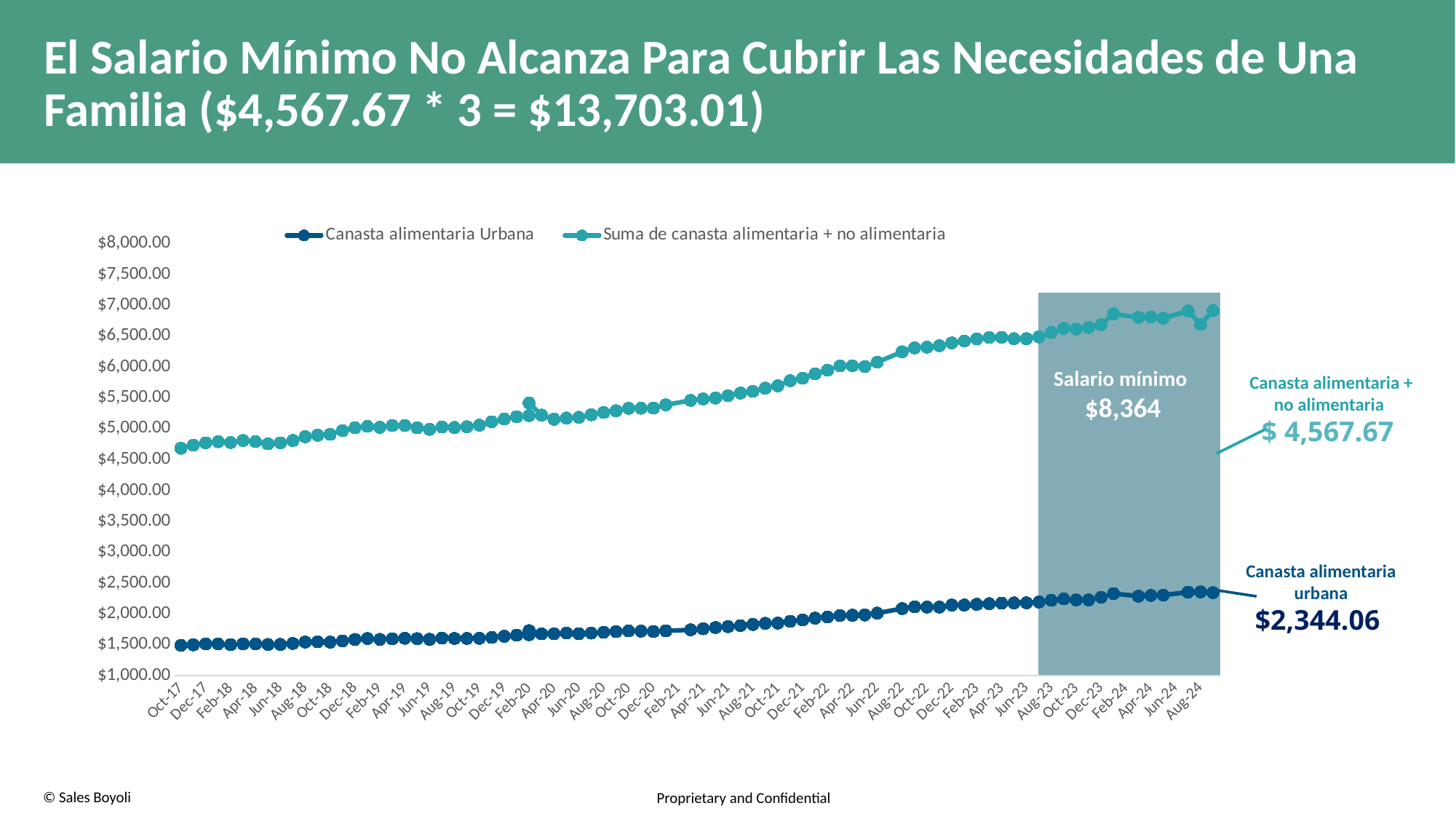
What Salario mínimo value is shown in the shaded region of the chart? $8,364 Is the value of Suma de canasta alimentaria + no alimentaria at Aug-24 greater or less than $6,500.00? greater How many series does the chart legend list? 2 Is the value of Suma de canasta alimentaria + no alimentaria at Oct-17 greater or less than $5,000.00? less What are the two series named in the chart legend? Canasta alimentaria Urbana; Suma de canasta alimentaria + no alimentaria What value is annotated on the chart for Canasta alimentaria urbana? $2,344.06 Do the values of the Suma de canasta alimentaria + no alimentaria series rise or fall from Oct-17 to Aug-24? rise Is the value of Canasta alimentaria Urbana at Aug-24 greater or less than $2,000.00? greater What kind of chart is shown on the slide? line chart Do the values of the Canasta alimentaria Urbana series rise or fall from Oct-17 to Aug-24? rise Which series has higher values throughout the chart, Canasta alimentaria Urbana or Suma de canasta alimentaria + no alimentaria? Suma de canasta alimentaria + no alimentaria